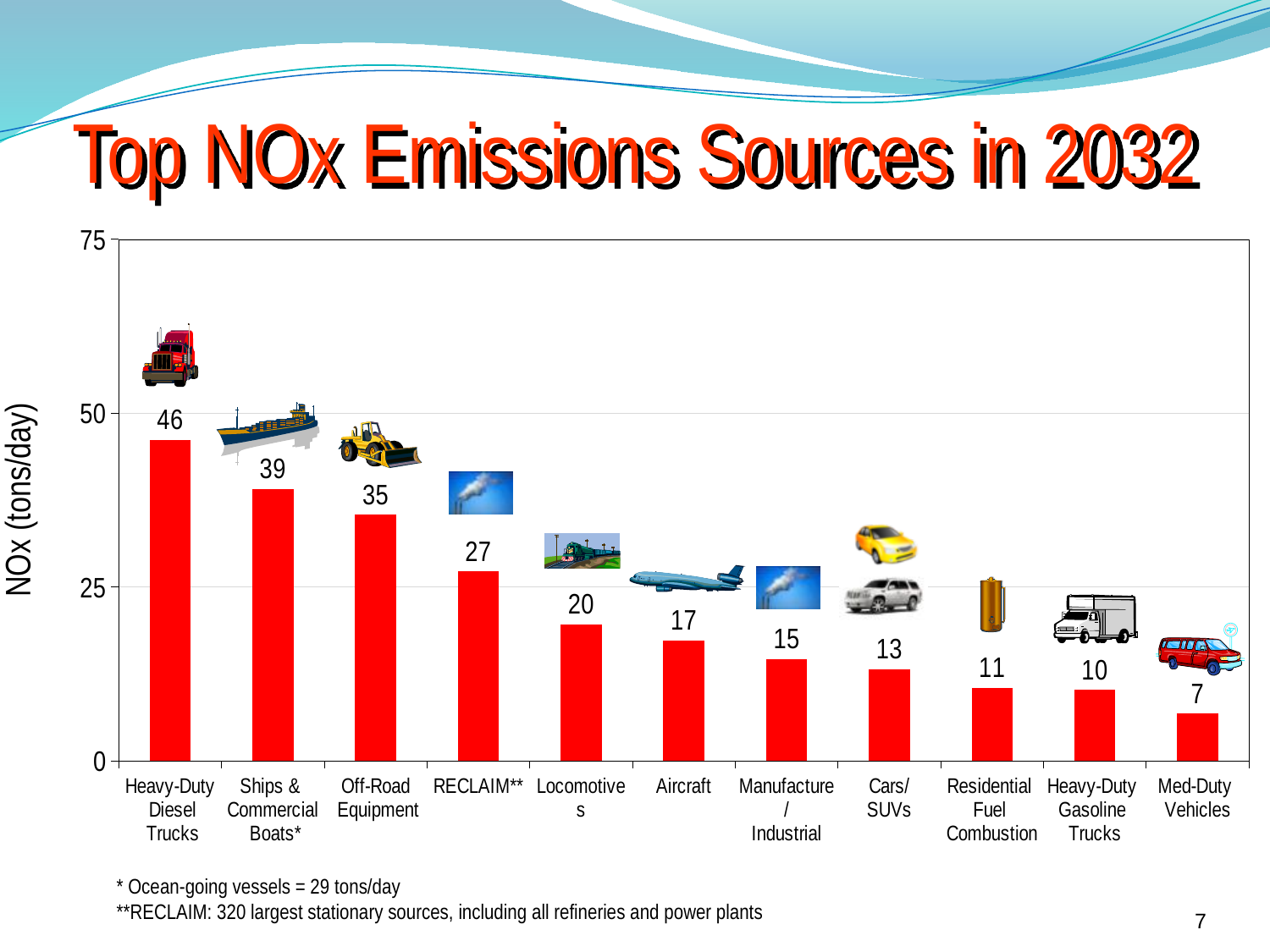
Which category has the lowest NOx emissions? Med-Duty Vehicles What is the difference between the NOx emissions of Ships & Commercial Boats* and Off-Road Equipment? 4 Do the values rise or fall from left to right along the x axis? Fall What is the NOx emissions value for Aircraft? 17 How many emission source categories are shown in the chart? 11 What is the NOx emissions value for Heavy-Duty Diesel Trucks? 46 Which category has the highest NOx emissions? Heavy-Duty Diesel Trucks What type of chart is shown on the slide? Bar chart What is the NOx emissions value for RECLAIM**? 27 Is the value for Off-Road Equipment greater or less than 25? greater Which has higher NOx emissions, Locomotives or Cars/SUVs? Locomotives What is the label of the y axis? NOx (tons/day)